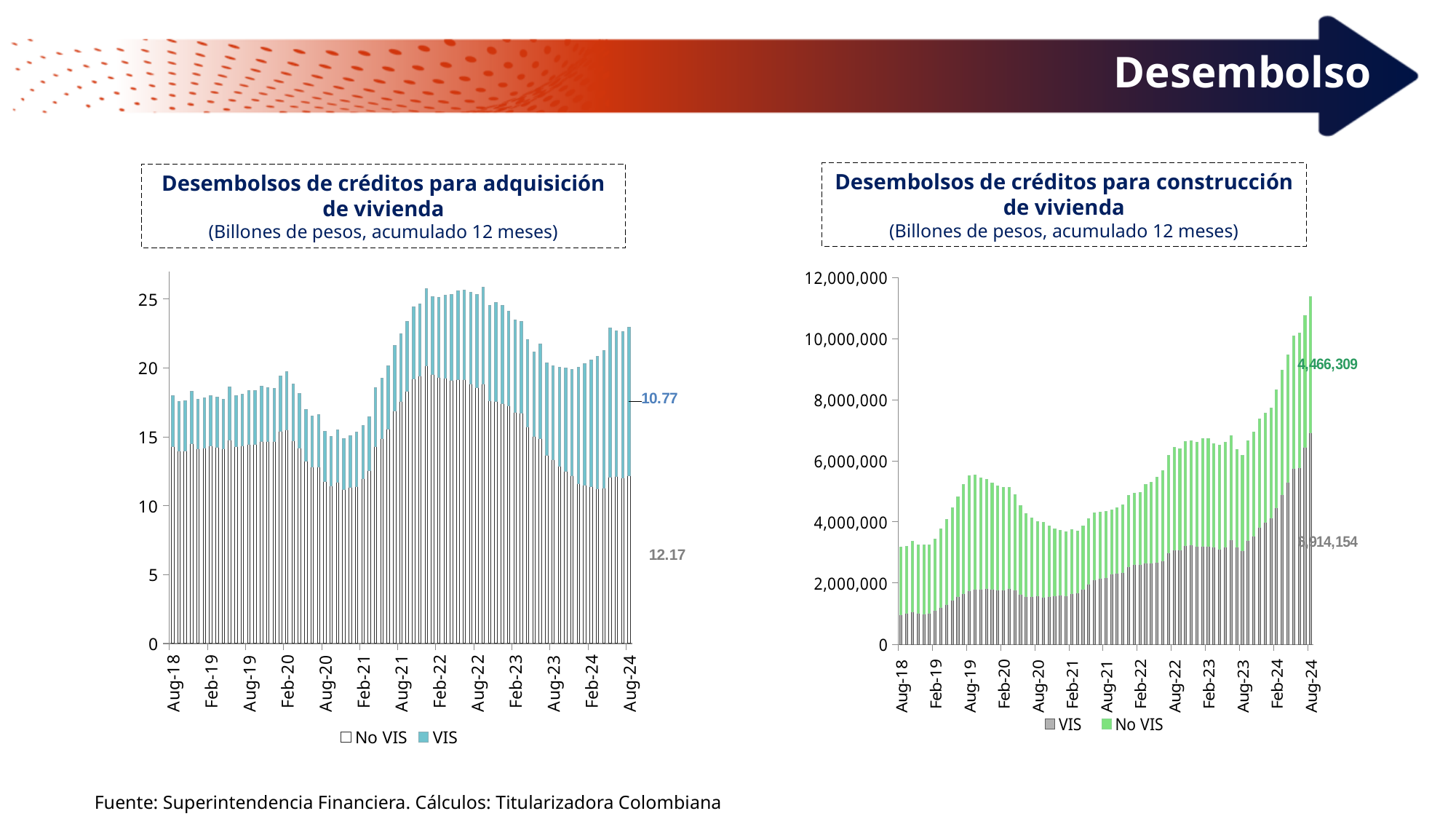
In the 'Desembolsos de créditos para adquisición de vivienda' chart, what is the VIS value labelled at Aug-24? 10.77 In the 'Desembolsos de créditos para construcción de vivienda' chart, which month has the highest total bar? Aug-24 In the 'Desembolsos de créditos para adquisición de vivienda' chart, what is the difference between the No VIS and VIS values at Aug-24? 1.40 In the 'Desembolsos de créditos para construcción de vivienda' chart, is the total of the Aug-24 bar greater or less than 10,000,000? greater What are the two legend entries of the 'Desembolsos de créditos para construcción de vivienda' chart? VIS and No VIS In the 'Desembolsos de créditos para adquisición de vivienda' chart, what is the No VIS value labelled at Aug-24? 12.17 In the 'Desembolsos de créditos para adquisición de vivienda' chart, what is the total of the stacked bar at Aug-24? 22.94 What kind of chart is the 'Desembolsos de créditos para adquisición de vivienda' chart? Stacked bar chart In the 'Desembolsos de créditos para construcción de vivienda' chart, what is the No VIS value labelled at Aug-24? 4,466,309 In the 'Desembolsos de créditos para adquisición de vivienda' chart, which series is larger at Aug-24, VIS or No VIS? No VIS How many series does the legend of the 'Desembolsos de créditos para adquisición de vivienda' chart list? 2 In the 'Desembolsos de créditos para adquisición de vivienda' chart, is the total of the Aug-18 bar greater or less than 20? less